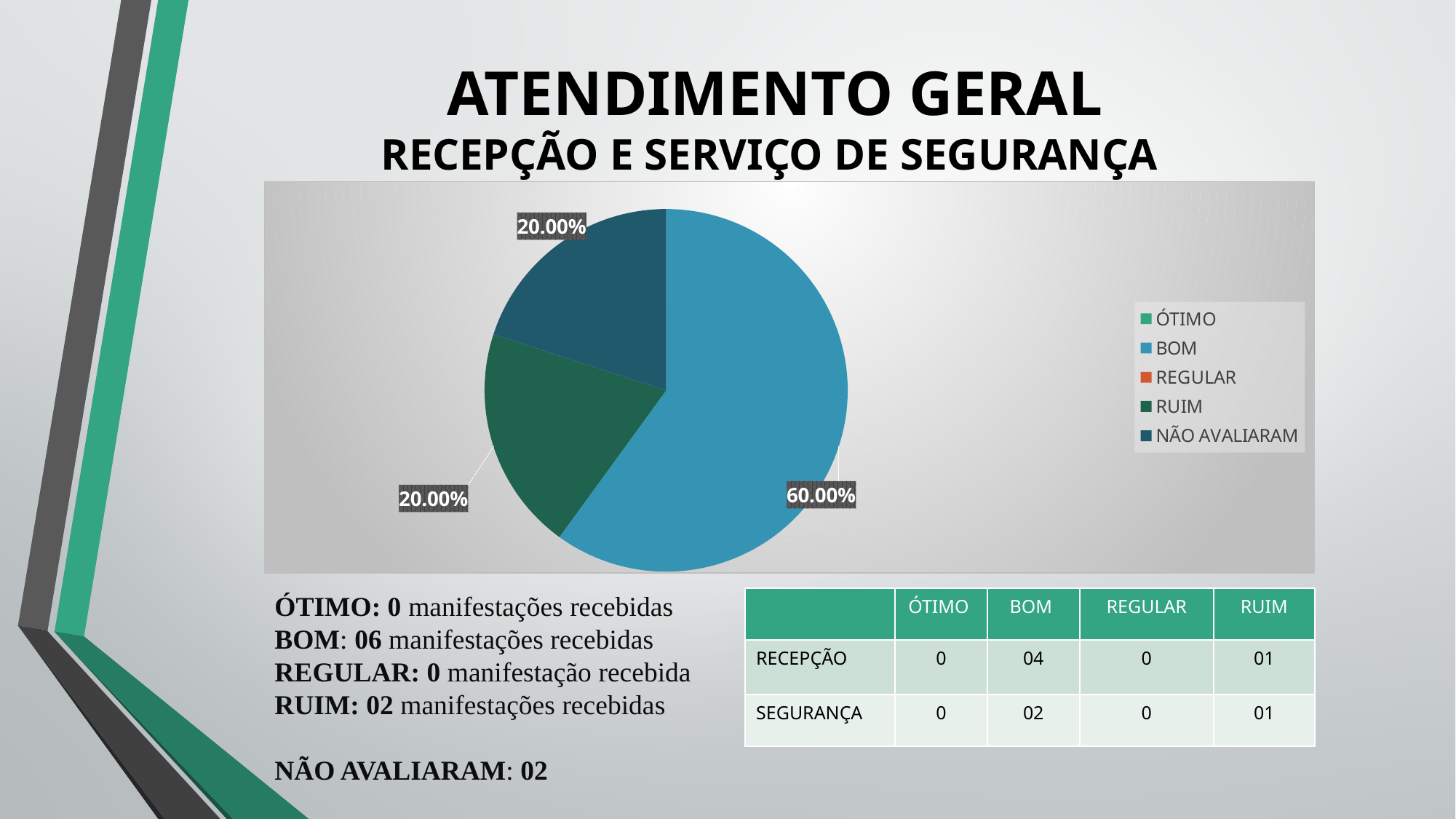
What colour is the BOM slice in the pie chart? blue Which legend entry is listed first? ÓTIMO What share of the pie does BOM represent? 60.00% What share of the pie does RUIM represent? 20.00% Is the share for BOM greater or less than 50%? greater How many entries does the legend list? 5 What kind of chart is shown on the slide? pie chart Which is larger, the share for BOM or the share for RUIM? BOM Which category has the largest slice of the pie? BOM What share of the pie does NÃO AVALIARAM represent? 20.00% How many slices are visible in the pie chart? 3 What is the difference between the share for BOM and the share for NÃO AVALIARAM? 40.00%